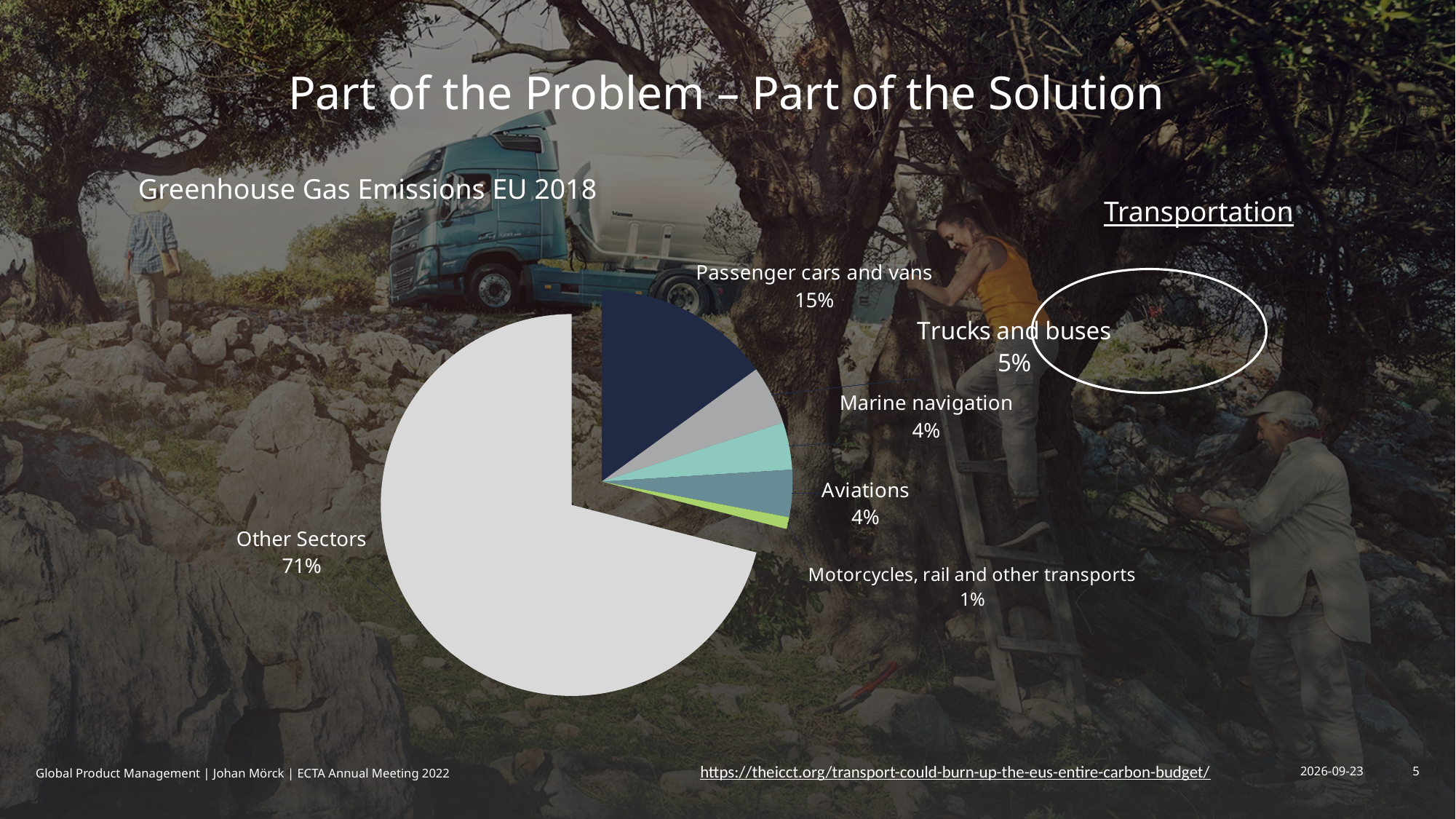
Which is larger, the share for Trucks and buses or the share for Aviations? Trucks and buses What kind of chart is shown on the slide? Pie chart Which category has the largest slice of the pie? Other Sectors Which category has the smallest slice of the pie? Motorcycles, rail and other transports What share of greenhouse gas emissions is attributed to Trucks and buses? 5% What share of greenhouse gas emissions is attributed to Marine navigation? 4% What share of greenhouse gas emissions is attributed to Passenger cars and vans? 15% What share of greenhouse gas emissions is attributed to Other Sectors? 71% What is the difference in percentage points between Passenger cars and vans and Trucks and buses? 10 percentage points What is the title of the chart? Greenhouse Gas Emissions EU 2018 What share of greenhouse gas emissions is attributed to Motorcycles, rail and other transports? 1% How many slices does the pie chart have? 6